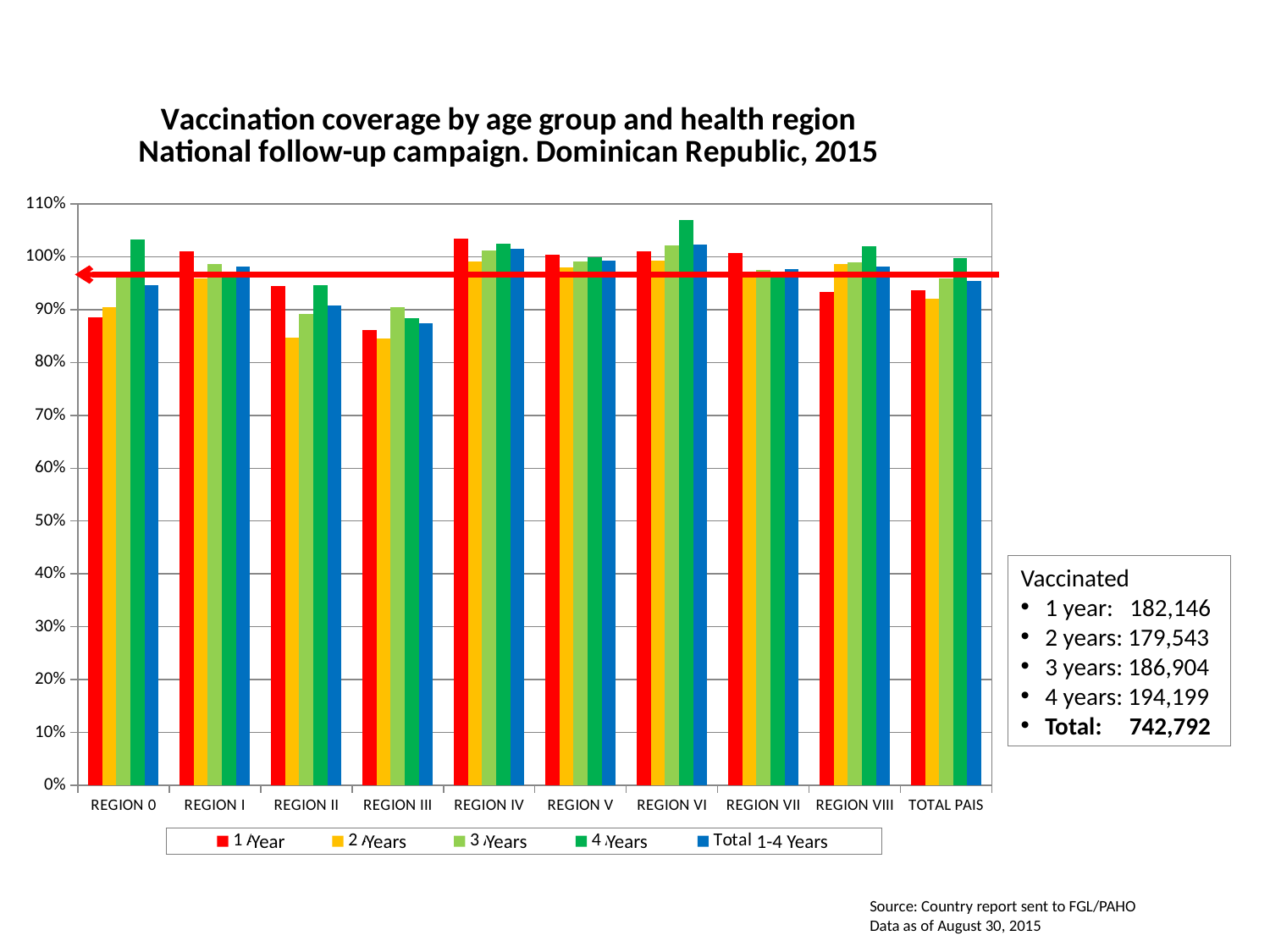
Is the 2 Years value for REGION II greater or less than 90%? less What kind of chart is shown on the slide? bar chart Which region has the lowest Total 1-4 Years value? REGION III For REGION 0, which is larger: the 1 Year value or the 4 Years value? 4 Years How many series does the chart's legend list? 5 Which series is shown in red in the chart's legend? 1 Year Is the 2 Years value for REGION III greater or less than 90%? less Is the 4 Years value for REGION VI greater or less than 100%? greater How many categories are shown along the x axis of the chart? 10 Which category has the highest 4 Years value? REGION VI For REGION II, which is larger: the 2 Years value or the 4 Years value? 4 Years